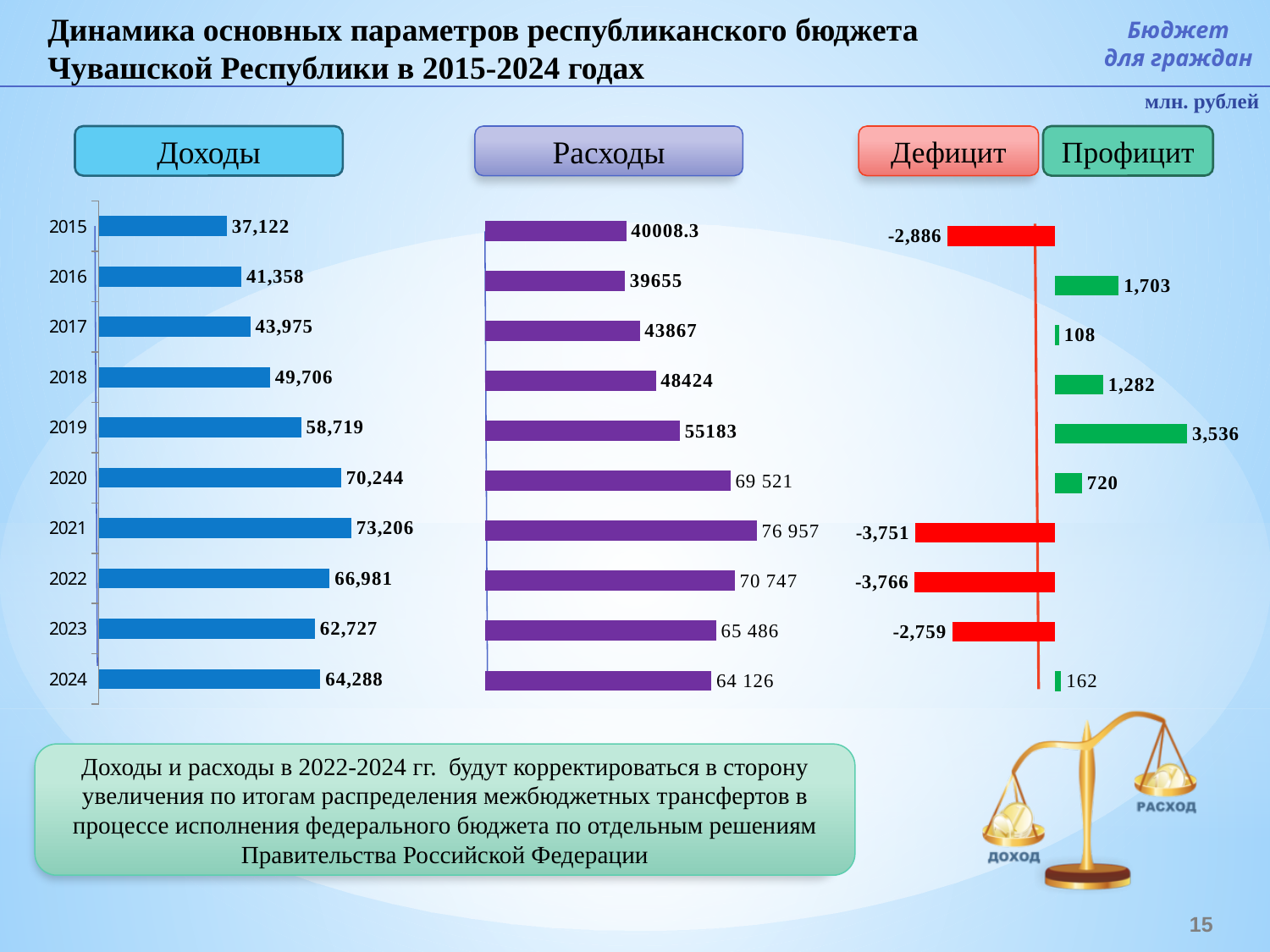
On the Доходы chart, what is the value for 2019? 58,719 On the Доходы chart, do the values rise or fall from 2015 to 2021? rise On the Расходы chart, which is larger: the value for 2020 or the value for 2024? 2020 On the Доходы chart, what is the difference between the values for 2021 and 2020? 2,962 On the Доходы chart, which year has the lowest value? 2015 How many years are shown on the Доходы chart? 10 On the Дефицит/Профицит chart, what is the value for 2022? -3,766 On the Доходы chart, which year has the highest value? 2021 On the Расходы chart, what is the value for 2021? 76 957 On the Дефицит/Профицит chart, which year has the largest surplus (профицит)? 2019 On the Дефицит/Профицит chart, what is the value for 2019? 3,536 On the Расходы chart, which year has the highest value? 2021